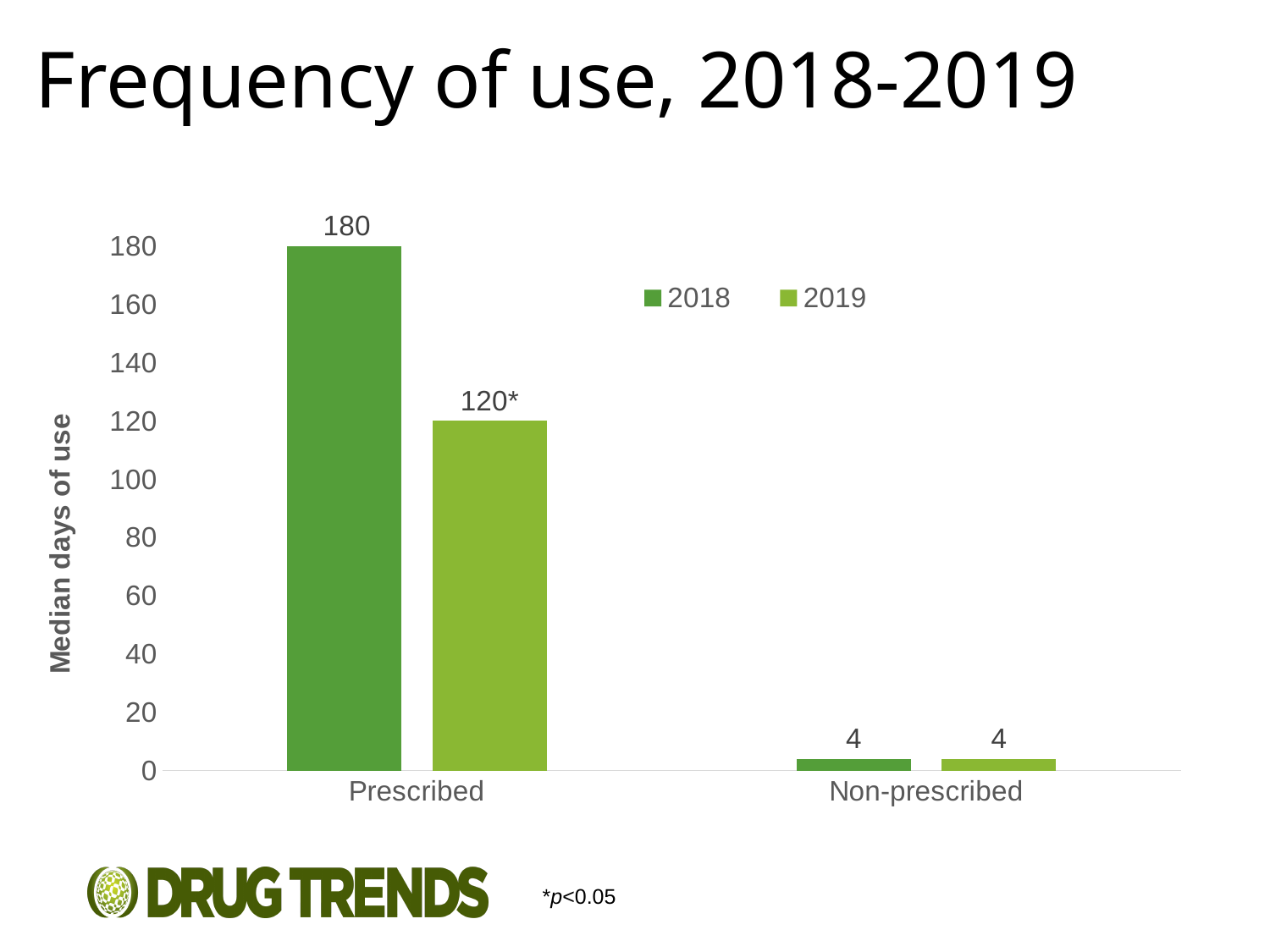
Which is larger for Prescribed: the 2018 value or the 2019 value? 2018 What is the label of the y axis? Median days of use What is the median days of use for Non-prescribed in 2019? 4 How many series does the legend list? 2 What kind of chart is shown on the slide? Bar chart What is the median days of use for Prescribed in 2018? 180 What is the median days of use for Non-prescribed in 2018? 4 What is the difference in median days of use for Prescribed between 2018 and 2019? 60 Which category has the lowest median days of use in 2019? Non-prescribed What is the median days of use for Prescribed in 2019? 120* Which category has the highest median days of use in 2018? Prescribed How many categories are shown on the x axis? 2